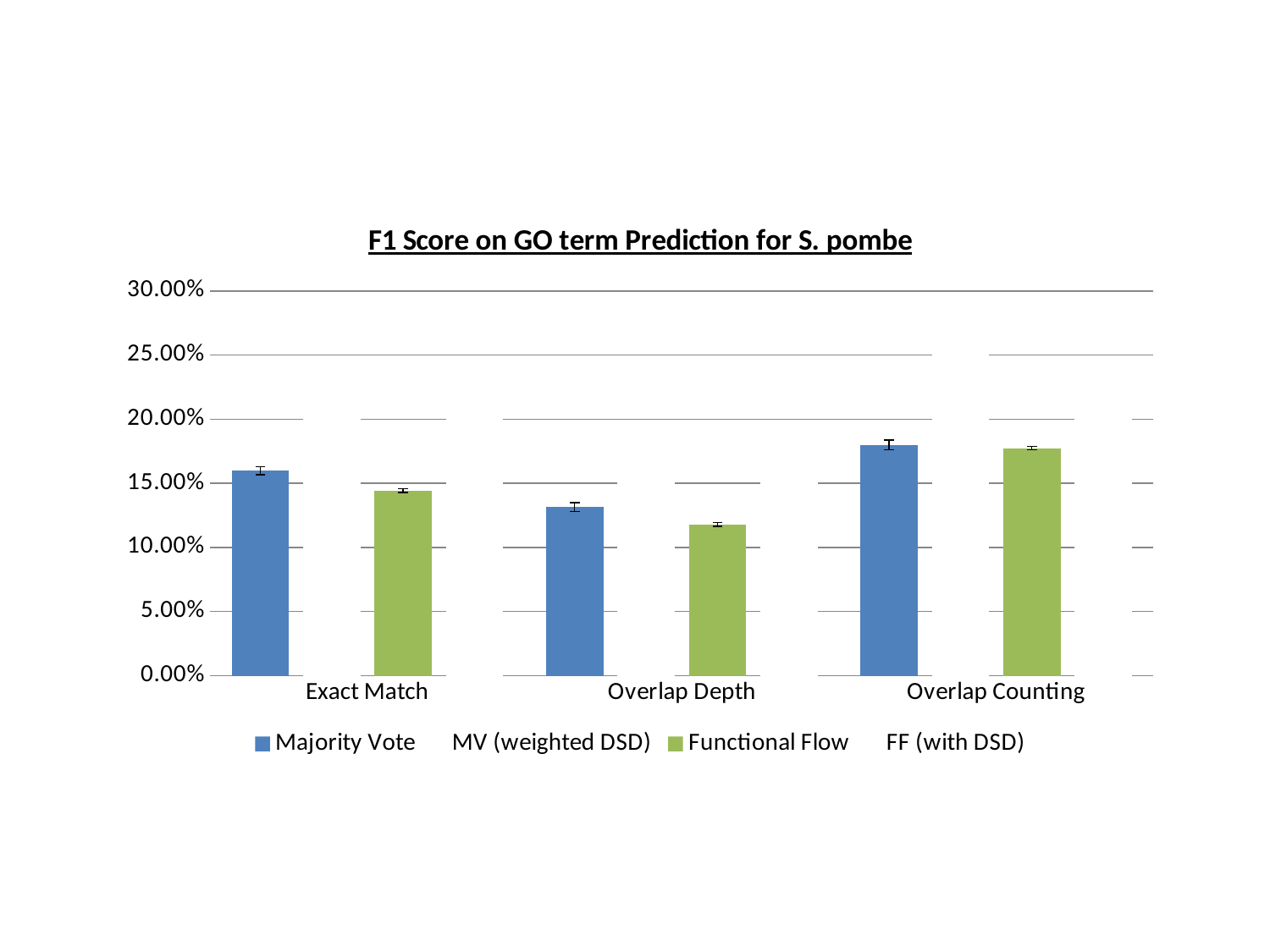
What kind of chart is shown on the slide? bar chart For Exact Match, which is larger: Majority Vote or Functional Flow? Majority Vote Is the Functional Flow value for Exact Match greater or less than 15.00%? less How many categories are shown on the x axis of the chart? 3 Is the Majority Vote value for Exact Match greater or less than 15.00%? greater Is the Majority Vote value for Overlap Depth greater or less than 15.00%? less For which category is the Majority Vote bar the highest? Overlap Counting For which category is the Functional Flow bar the lowest? Overlap Depth How many entries does the chart's legend list? 4 What is the title of the chart? F1 Score on GO term Prediction for S. pombe